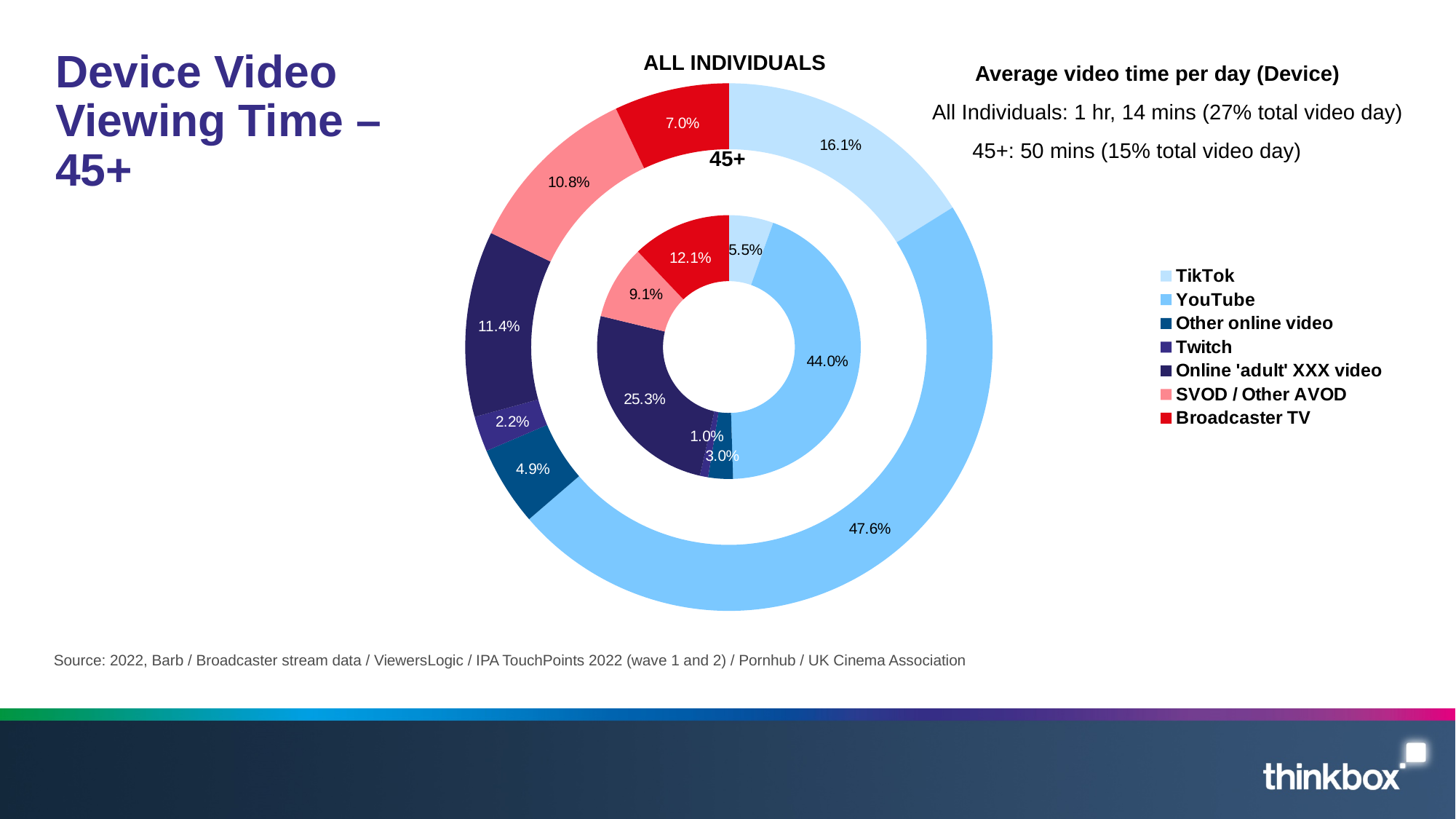
Which legend entry is shown in red? Broadcaster TV In the outer ring (All Individuals), what is the share for YouTube? 47.6% In the inner ring (45+), what is the share for Online 'adult' XXX video? 25.3% In the inner ring (45+), what is the share for Broadcaster TV? 12.1% What is the difference between the SVOD / Other AVOD share in the outer ring and the inner ring? 1.7% What is the difference between the TikTok share for All Individuals (outer ring) and for 45+ (inner ring)? 10.6% What kind of chart is shown on the slide? Doughnut chart Which is larger: the Broadcaster TV share for All Individuals (outer ring) or for 45+ (inner ring)? 45+ (inner ring) In the outer ring (All Individuals), what is the share for TikTok? 16.1% Which category has the smallest share in the outer ring (All Individuals)? Twitch How many categories does the legend list? 7 Which category has the largest share in the inner ring (45+)? YouTube